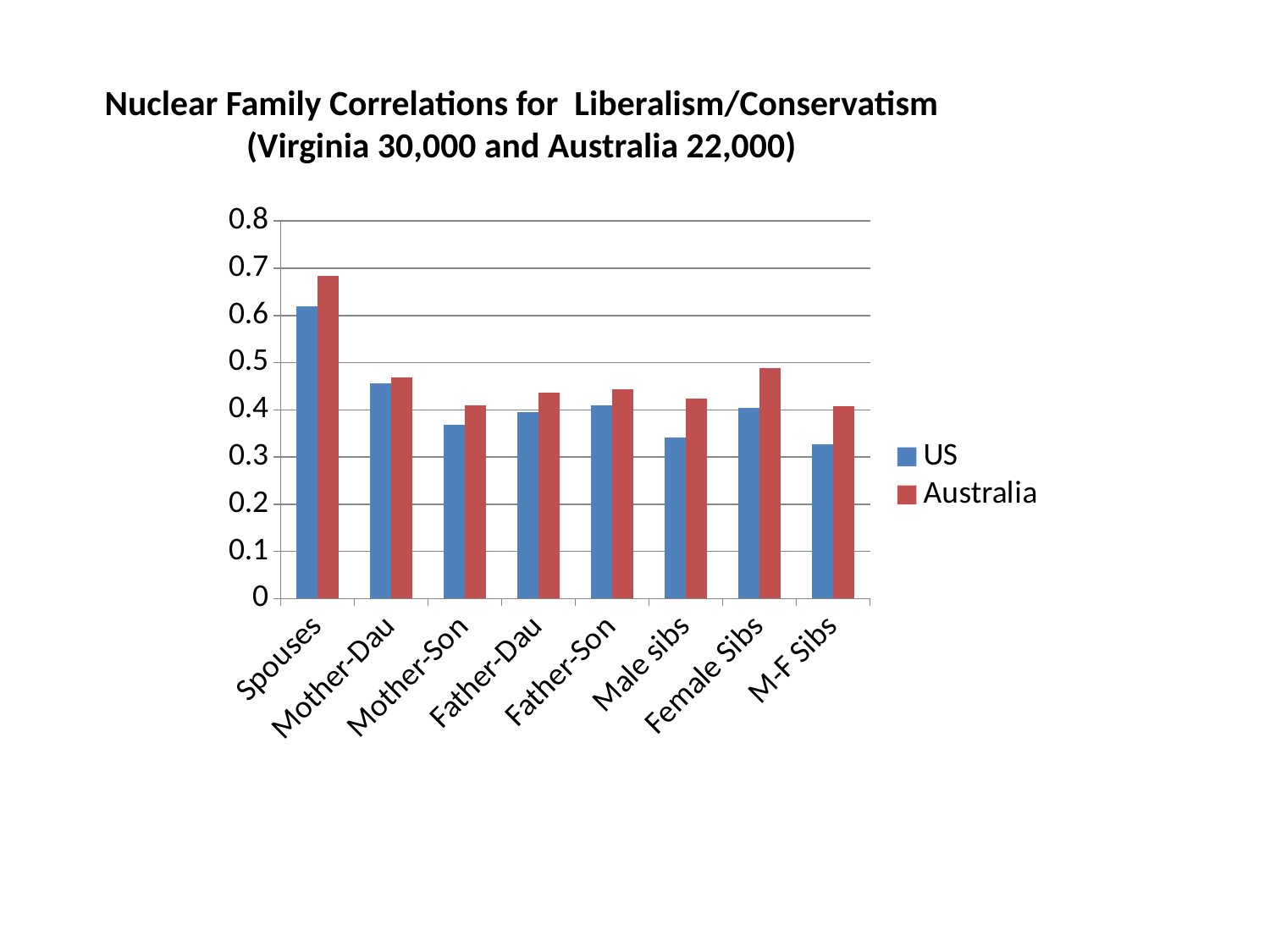
Which category has the highest Australia correlation? Spouses For Male sibs, which series has the larger value, US or Australia? Australia How many series does the legend list? 2 Is the Australia value for Female Sibs greater or less than 0.4? greater What kind of chart is shown on the slide? bar chart Which category has the highest US correlation? Spouses Which is larger for the US series: Spouses or Mother-Dau? Spouses How many family-pair categories are shown on the x axis? 8 Is the Australia value for Spouses greater or less than 0.6? greater Is the US value for Mother-Dau greater or less than 0.4? greater What are the two entries in the legend? US and Australia